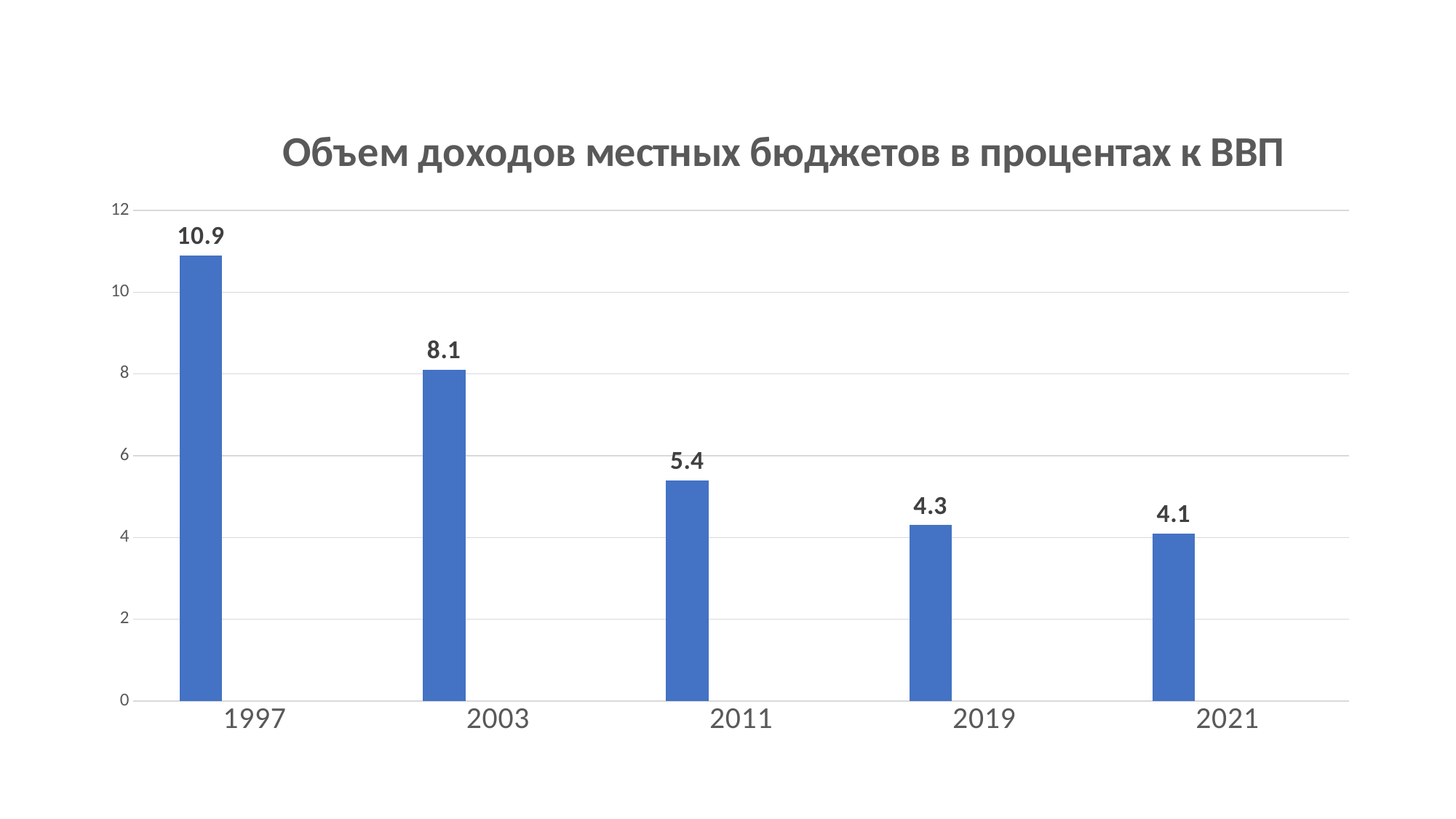
What kind of chart is this? bar chart What is the value for 2021? 4.1 How many years are shown on the x axis? 5 Is the value for 2003 greater or less than 8? greater Which year has the highest value? 1997 What is the difference between the values for 2011 and 2019? 1.1 Do the values rise or fall from 1997 to 2021? fall What is the value for 1997? 10.9 Which year has the lowest value? 2021 Which is larger, the value for 2003 or the value for 2011? 2003 What is the difference between the values for 1997 and 2003? 2.8 What is the value for 2011? 5.4